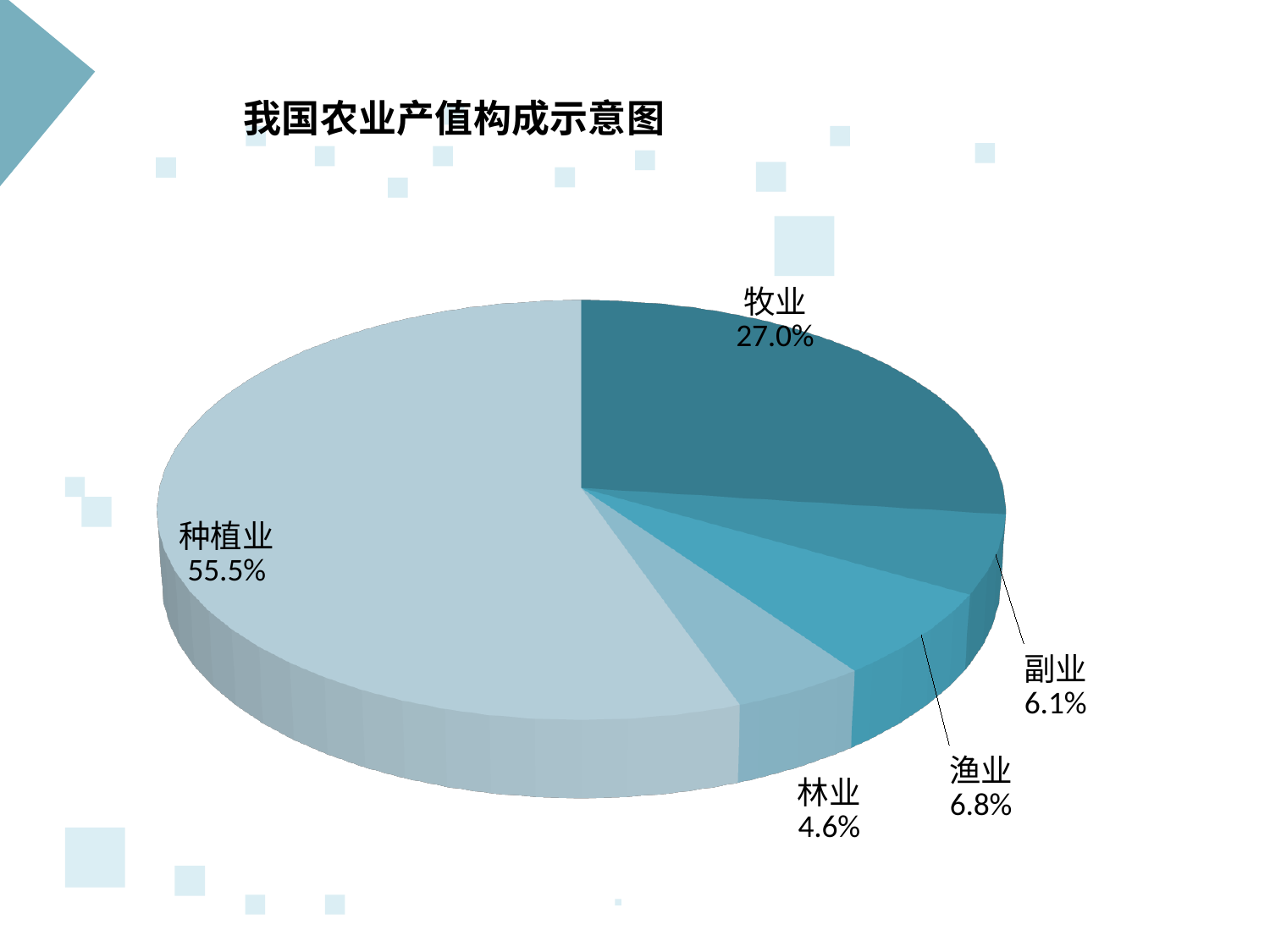
What is the value shown for 副业? 6.1% Which category has the smallest share of the pie? 林业 Which category has the largest share of the pie? 种植业 What is the title of the chart? 我国农业产值构成示意图 What is the value shown for 牧业? 27.0% What share of the pie does 种植业 account for? 55.5% What is the difference between the shares of 种植业 and 牧业? 28.5% How many categories are shown in the pie chart? 5 Which is larger, the share of 渔业 or the share of 副业? 渔业 What is the value shown for 林业? 4.6% What is the value shown for 渔业? 6.8% What kind of chart is shown on the slide? pie chart